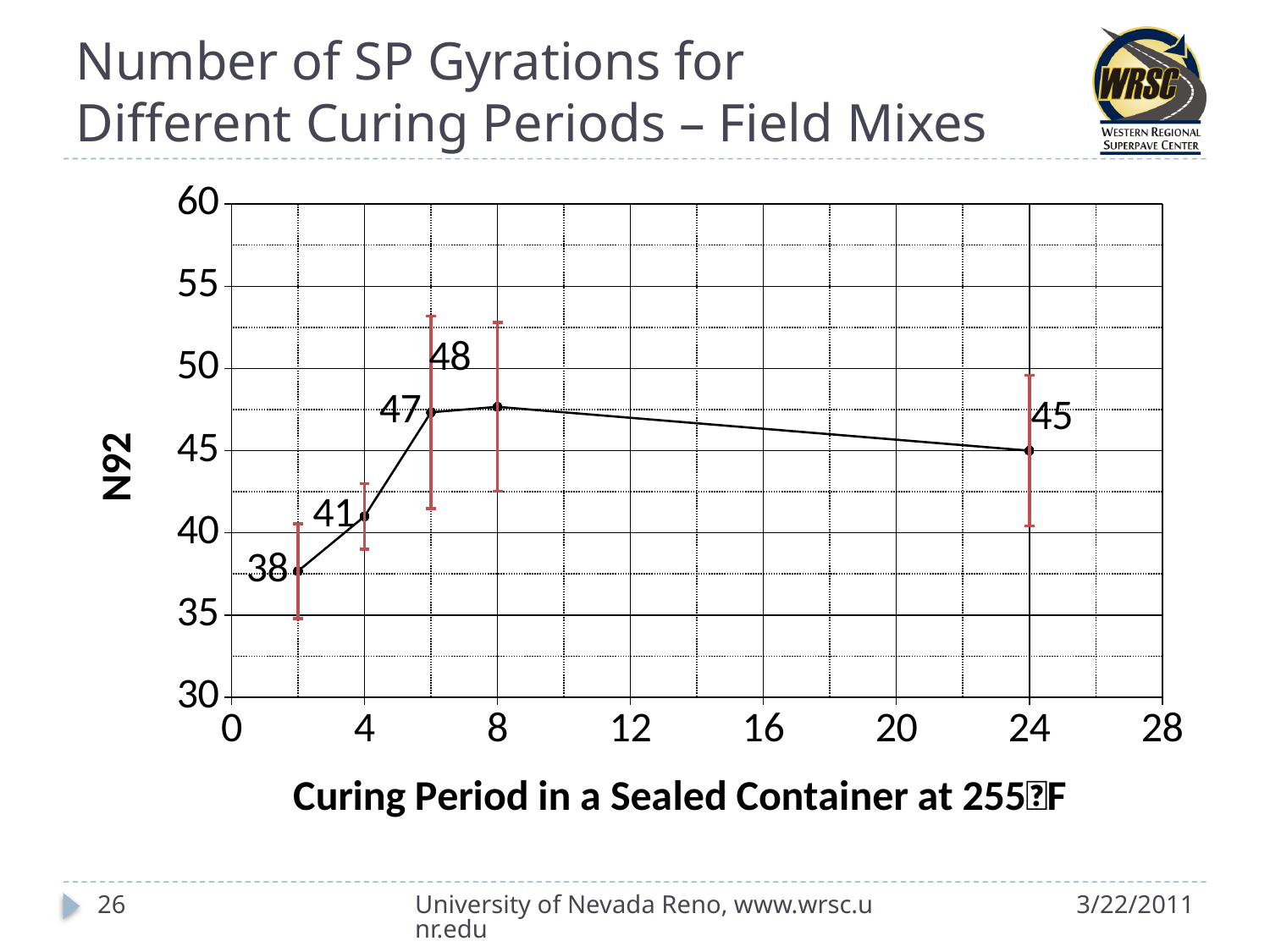
At which curing period is the N92 value lowest? 2 What is the N92 value at a curing period of 6 hours? 47 What is the N92 value at a curing period of 24 hours? 45 What is the difference between the N92 value at 8 hours and at 2 hours? 10 How many data points are plotted on the chart? 5 Does the N92 value rise or fall between the 8-hour and 24-hour curing periods? Fall What is the N92 value at a curing period of 2 hours? 38 What is the label of the vertical axis? N92 What is the N92 value at a curing period of 8 hours? 48 Which has a larger N92 value: the 4-hour curing period or the 24-hour curing period? 24-hour What kind of chart is shown on the slide? Line chart At which curing period is the N92 value highest? 8